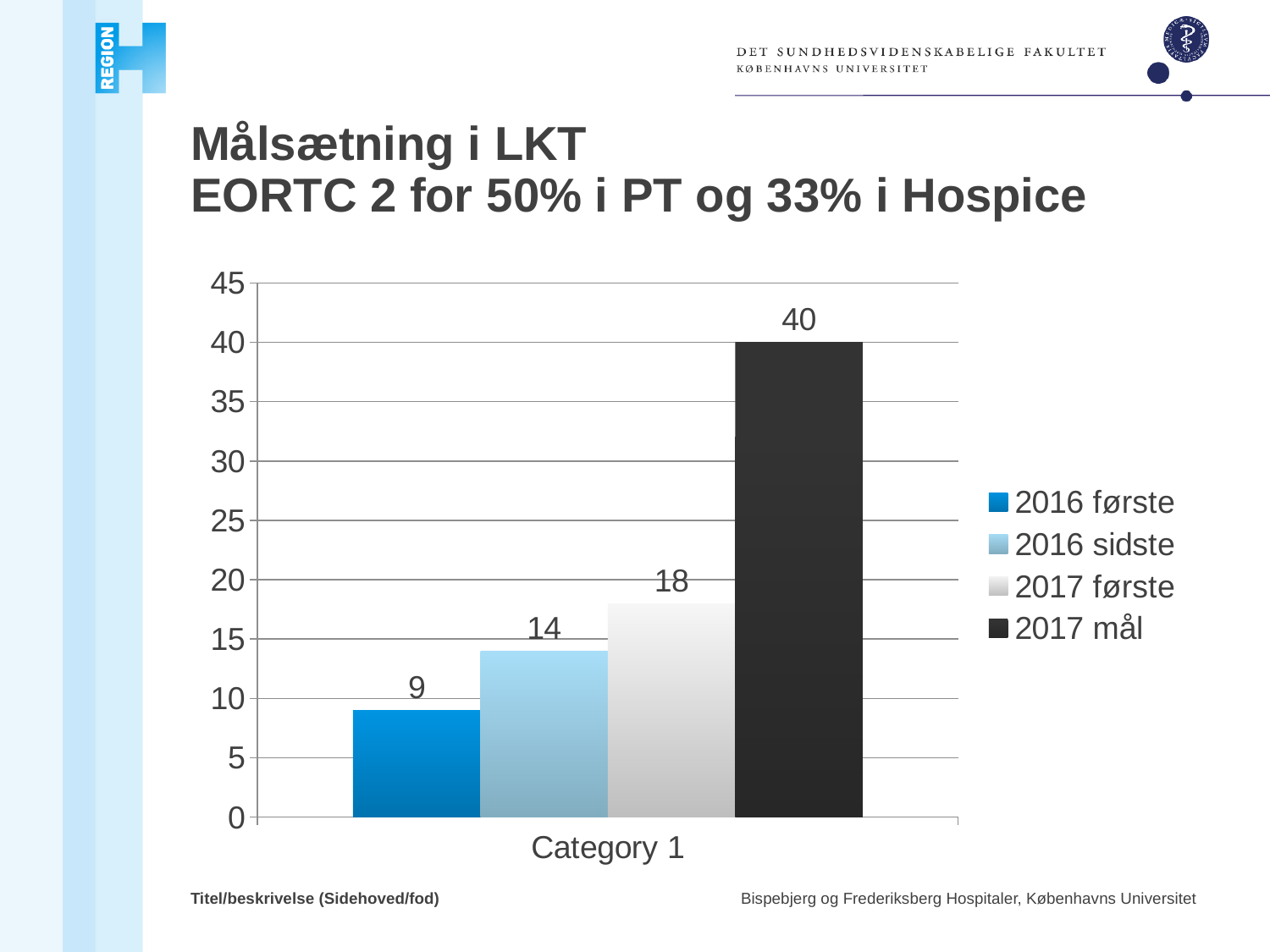
What is the difference between the '2016 sidste' value and the '2016 første' value? 5 Which series has the highest value? 2017 mål What is the value for the '2016 første' series? 9 Which series has the lowest value? 2016 første What is the value for the '2016 sidste' series? 14 What is the label of the category on the x axis? Category 1 What is the value for the '2017 første' series? 18 What is the value for the '2017 mål' series? 40 How many series does the legend list? 4 What is the difference between the '2017 mål' value and the '2017 første' value? 22 What kind of chart is shown on the slide? Bar chart Which is larger, the value for '2016 sidste' or the value for '2017 første'? 2017 første